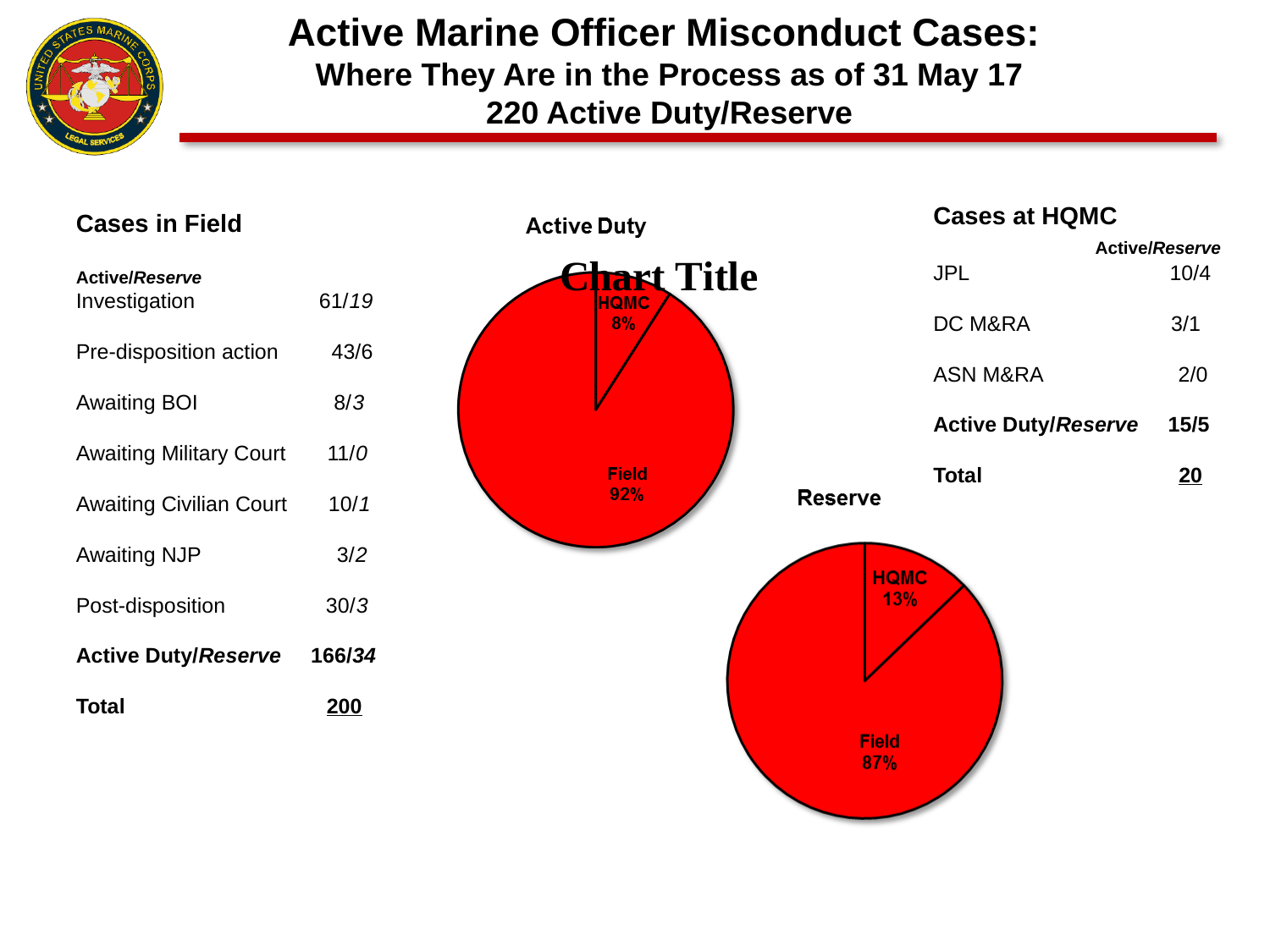
In the Reserve pie chart, what is the difference in percentage points between the Field and HQMC slices? 74 In the Reserve pie chart, what share is labelled for Field? 87% Which is larger: the HQMC share in the Active Duty pie chart or the HQMC share in the Reserve pie chart? Reserve In the Reserve pie chart, what share is labelled for HQMC? 13% What type of chart is the Reserve chart? Pie chart In the Active Duty pie chart, what share is labelled for Field? 92% In the Active Duty pie chart, what share is labelled for HQMC? 8% How many slices does the Active Duty pie chart have? 2 What placeholder title text is overlaid on the Active Duty pie chart? Chart Title In the Active Duty pie chart, which slice is the largest? Field In the Reserve pie chart, which slice is the smallest? HQMC How many pie charts are shown on the slide? 2